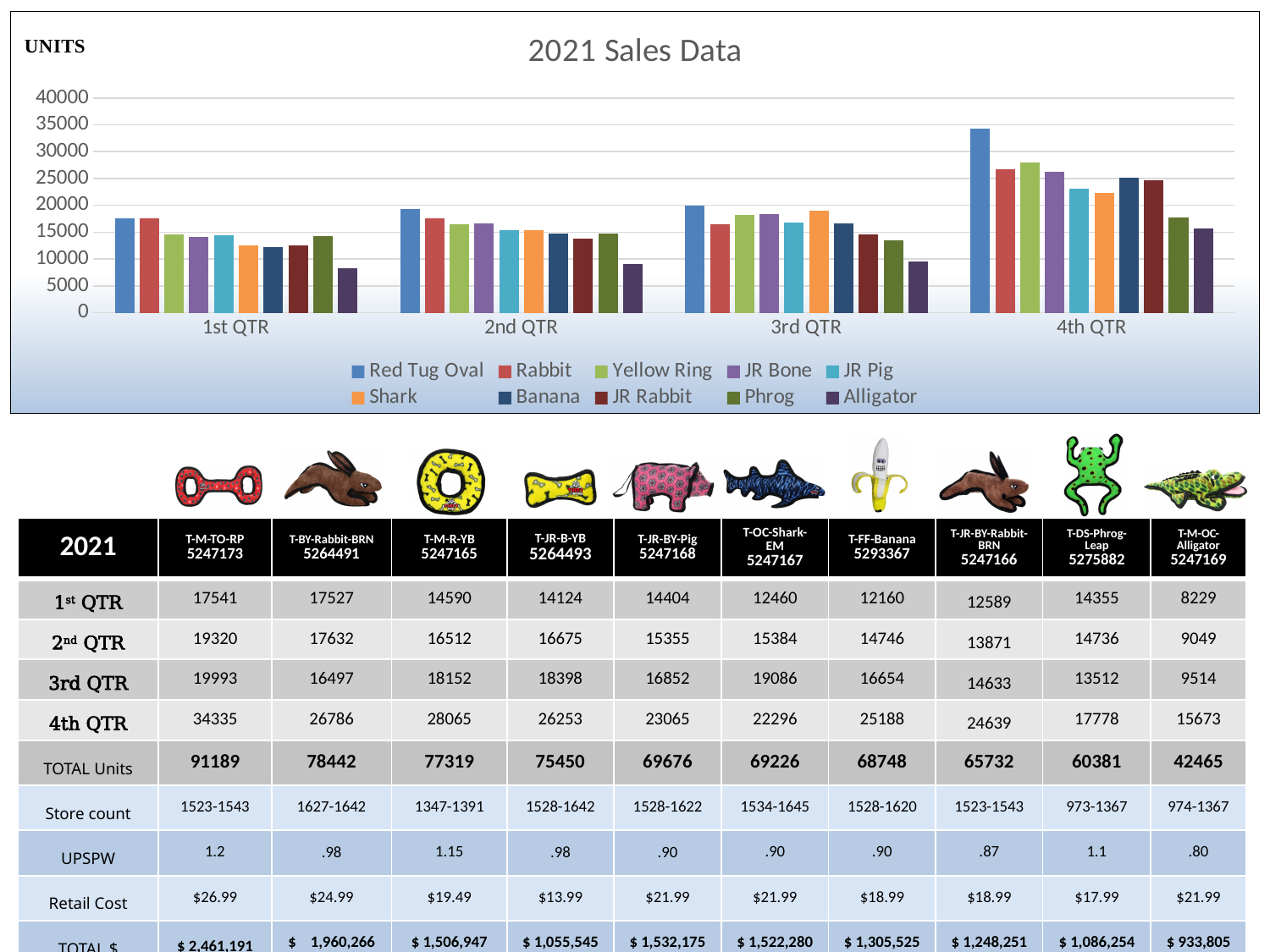
In the 1st QTR group, which series has the shortest bar? Alligator Is the value for Alligator in the 1st QTR greater or less than 10000? less In the 3rd QTR group, which bar is taller: Shark or Rabbit? Shark Do the Red Tug Oval bars rise or fall from 1st QTR to 4th QTR? rise What kind of chart is shown on the slide? bar chart How many quarter categories are shown on the x axis of the chart? 4 How many series does the legend of the 2021 Sales Data chart list? 10 In the 4th QTR group, which series has the tallest bar? Red Tug Oval Is the value for Red Tug Oval in the 4th QTR greater or less than 30000? greater Is the value for Banana in the 4th QTR greater or less than 20000? greater According to the table below the chart, how many units of Red Tug Oval (T-M-TO-RP) were sold in the 4th QTR? 34335 What is the title of the chart? 2021 Sales Data